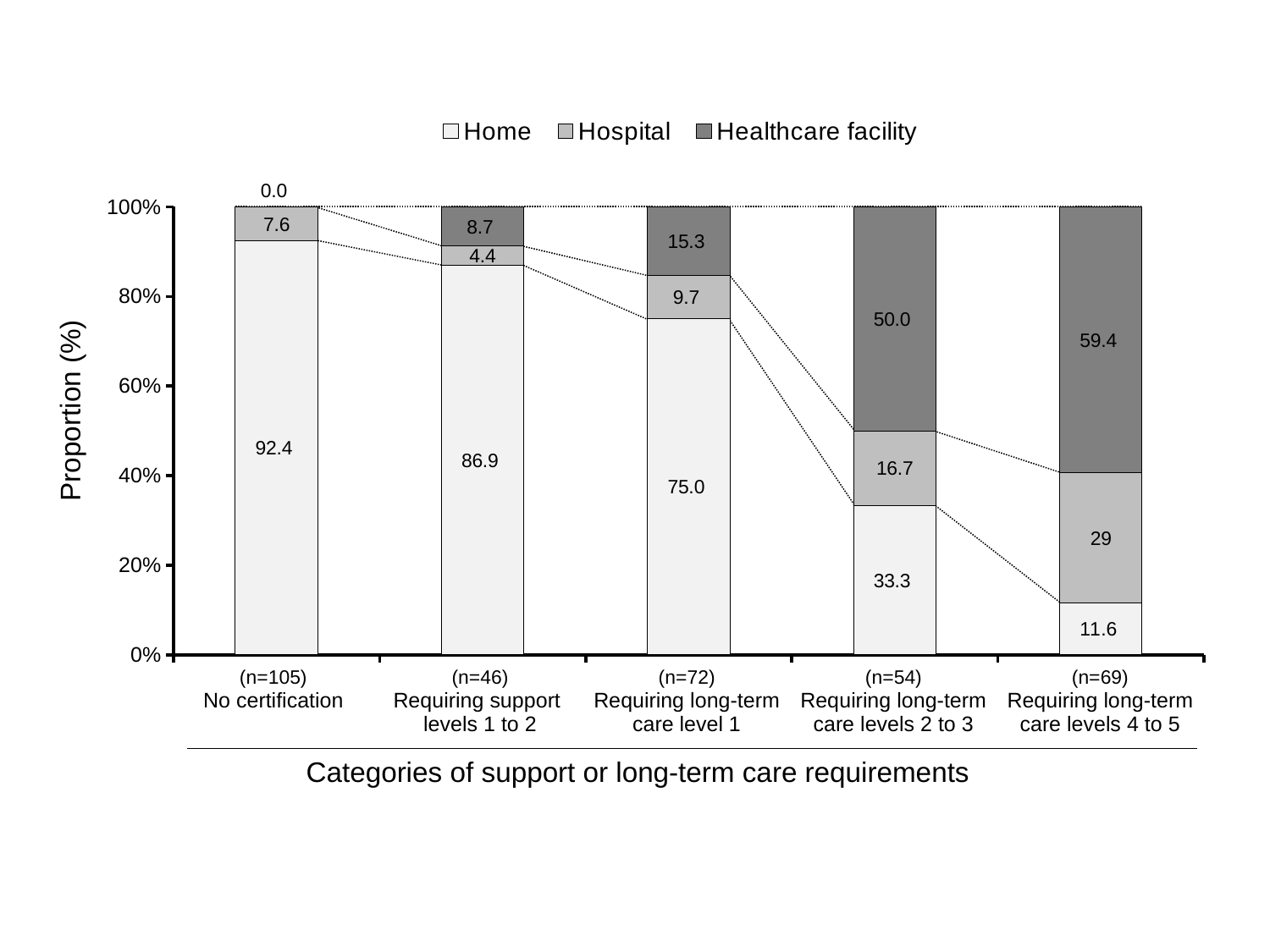
Which category has the lowest Healthcare facility proportion? No certification What is the Hospital proportion for 'Requiring long-term care level 1'? 9.7 What is the label of the y axis? Proportion (%) How does the Home proportion change from 'No certification' to 'Requiring long-term care levels 4 to 5'? It falls Is the Healthcare facility proportion larger for 'Requiring long-term care levels 2 to 3' or for 'Requiring long-term care level 1'? Requiring long-term care levels 2 to 3 How many categories are shown on the x axis? 5 Which category has the highest Home proportion? No certification What is the difference between the Home proportions for 'No certification' and 'Requiring long-term care levels 4 to 5'? 80.8 What is the Home proportion for the 'No certification' category? 92.4 What kind of chart is shown on the slide? Stacked bar chart How many series does the legend list? 3 What is the Healthcare facility proportion for 'Requiring long-term care levels 4 to 5'? 59.4